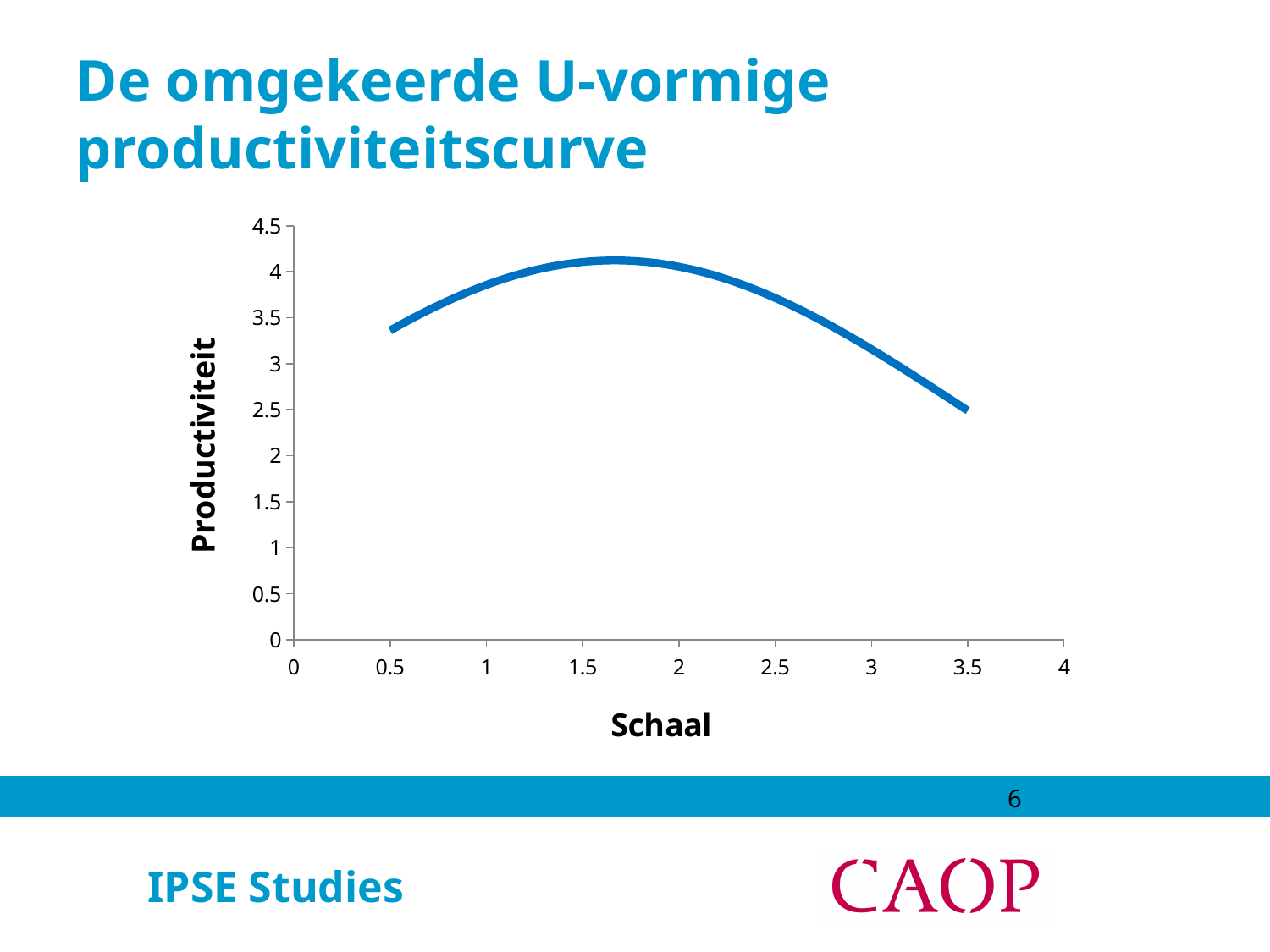
How many lines (series) are plotted on the chart? 1 Is the value of Productiviteit at Schaal 3 greater or less than 3.5? less What kind of chart is shown on the slide? line chart Which is larger: Productiviteit at Schaal 0.5 or at Schaal 3.5? Schaal 0.5 Which is larger: Productiviteit at Schaal 1 or at Schaal 3? Schaal 1 What is the title of the y axis? Productiviteit What is the title of the x axis? Schaal Is the highest point of the curve greater or less than 4? greater Is the value of Productiviteit at Schaal 3.5 greater or less than 3? less How does Productiviteit change as Schaal increases from 0.5 to 3.5? It rises first, then falls